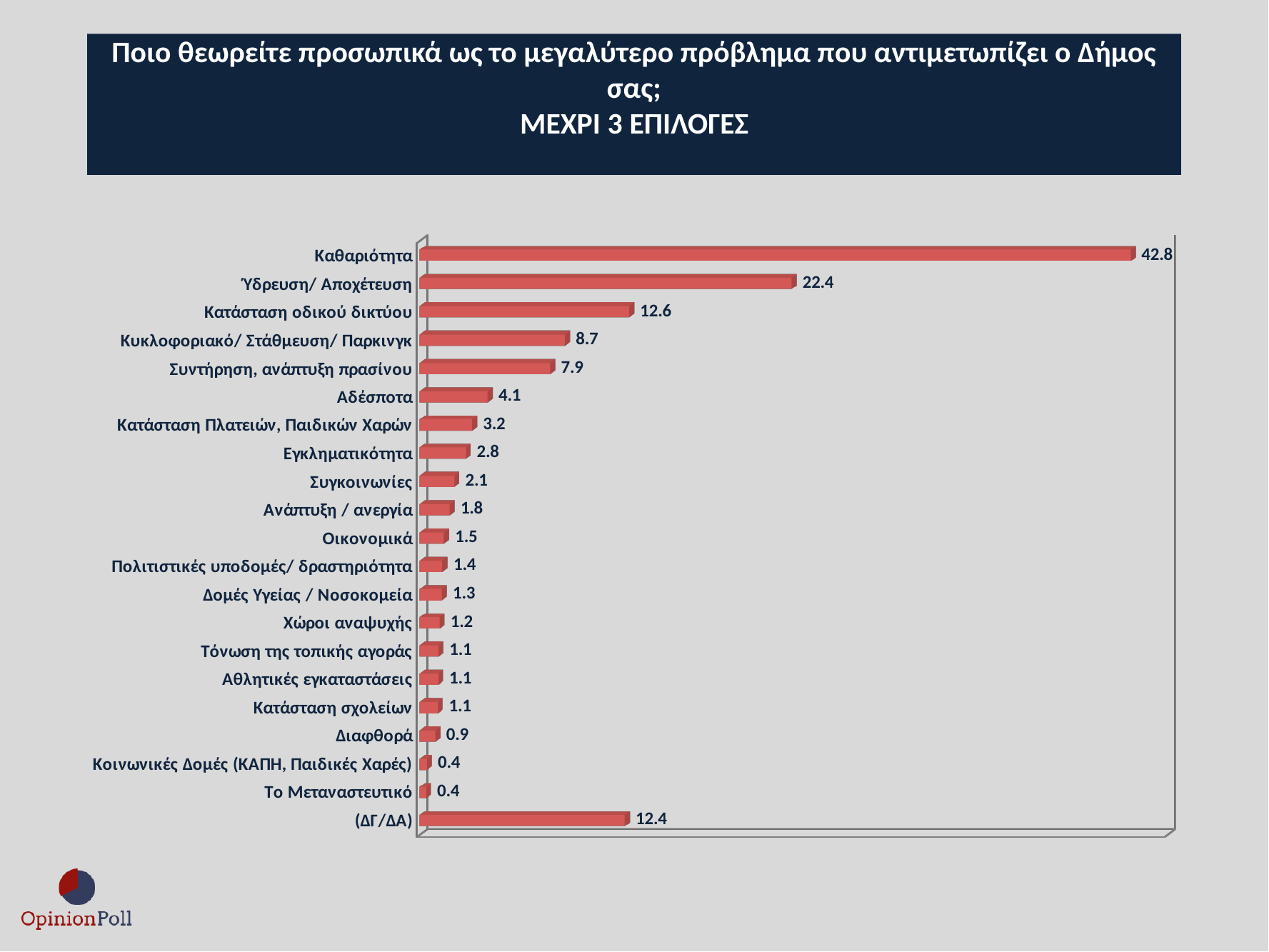
What value is shown for (ΔΓ/ΔΑ)? 12.4 Which is larger, the value for Εγκληματικότητα or the value for Συγκοινωνίες? Εγκληματικότητα What is the difference between the values for Κατάσταση οδικού δικτύου and (ΔΓ/ΔΑ)? 0.2 What is the difference between the values for Καθαριότητα and Ύδρευση/ Αποχέτευση? 20.4 What kind of chart is shown on the slide? Bar chart What value is shown for Καθαριότητα? 42.8 What value is shown for Διαφθορά? 0.9 Which is larger, the value for Κυκλοφοριακό/ Στάθμευση/ Παρκινγκ or the value for Συντήρηση, ανάπτυξη πρασίνου? Κυκλοφοριακό/ Στάθμευση/ Παρκινγκ Which category has the highest value? Καθαριότητα What value is shown for Αδέσποτα? 4.1 How many categories are plotted in the chart? 21 What value is shown for Ύδρευση/ Αποχέτευση? 22.4